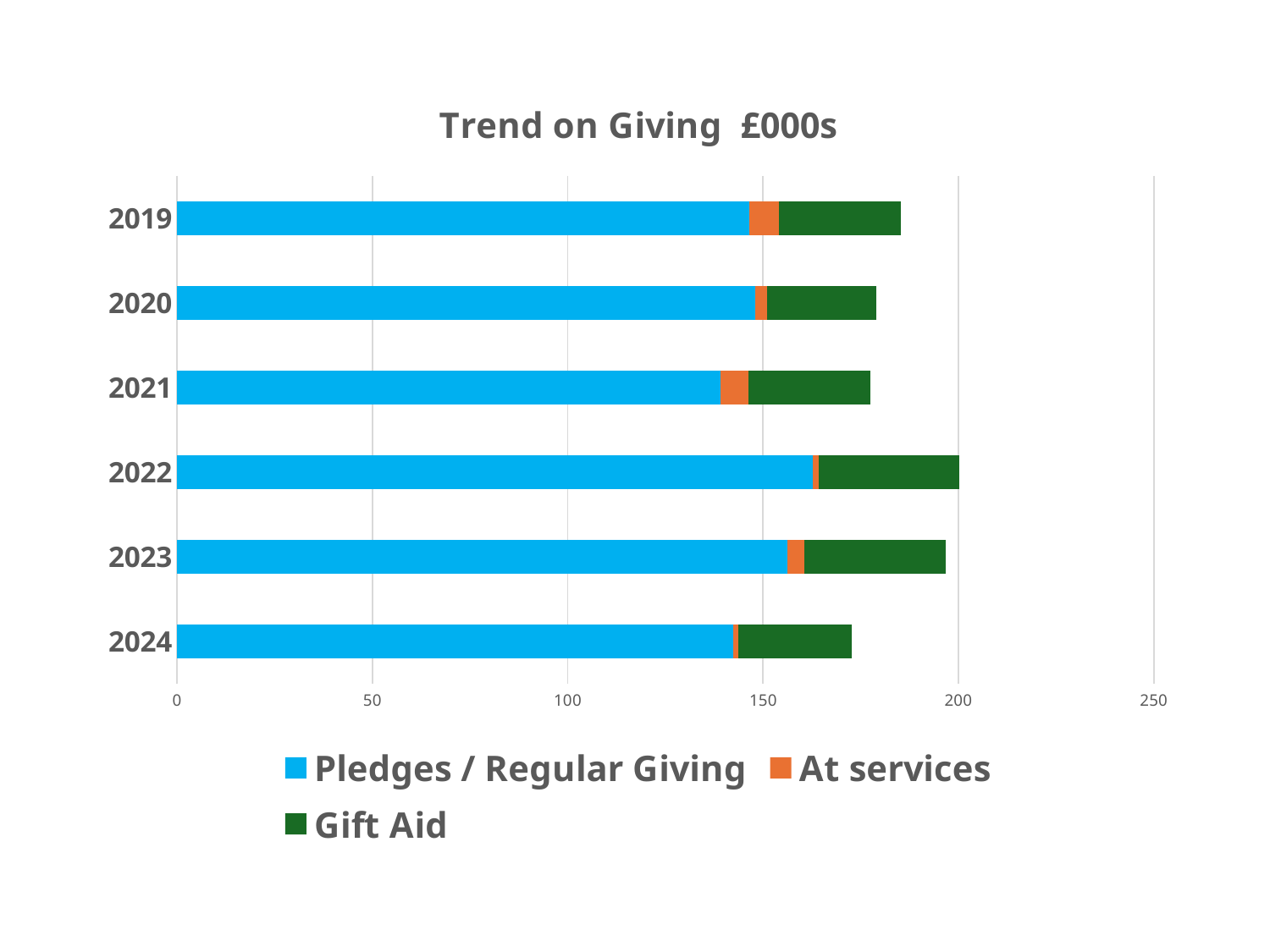
Is the value for Pledges / Regular Giving in 2024 greater or less than 150? less How many series does the legend list? 3 What kind of chart is shown on the slide? Stacked bar chart How many years are shown on the chart? 6 Which is larger, Pledges / Regular Giving in 2022 or in 2024? 2022 Which is larger, the At services value in 2019 or in 2024? 2019 Is the value for Pledges / Regular Giving in 2021 greater or less than 150? less Is the value for Pledges / Regular Giving in 2022 greater or less than 150? greater Which colour represents Gift Aid in the chart? Green What is the title of the chart? Trend on Giving £000s